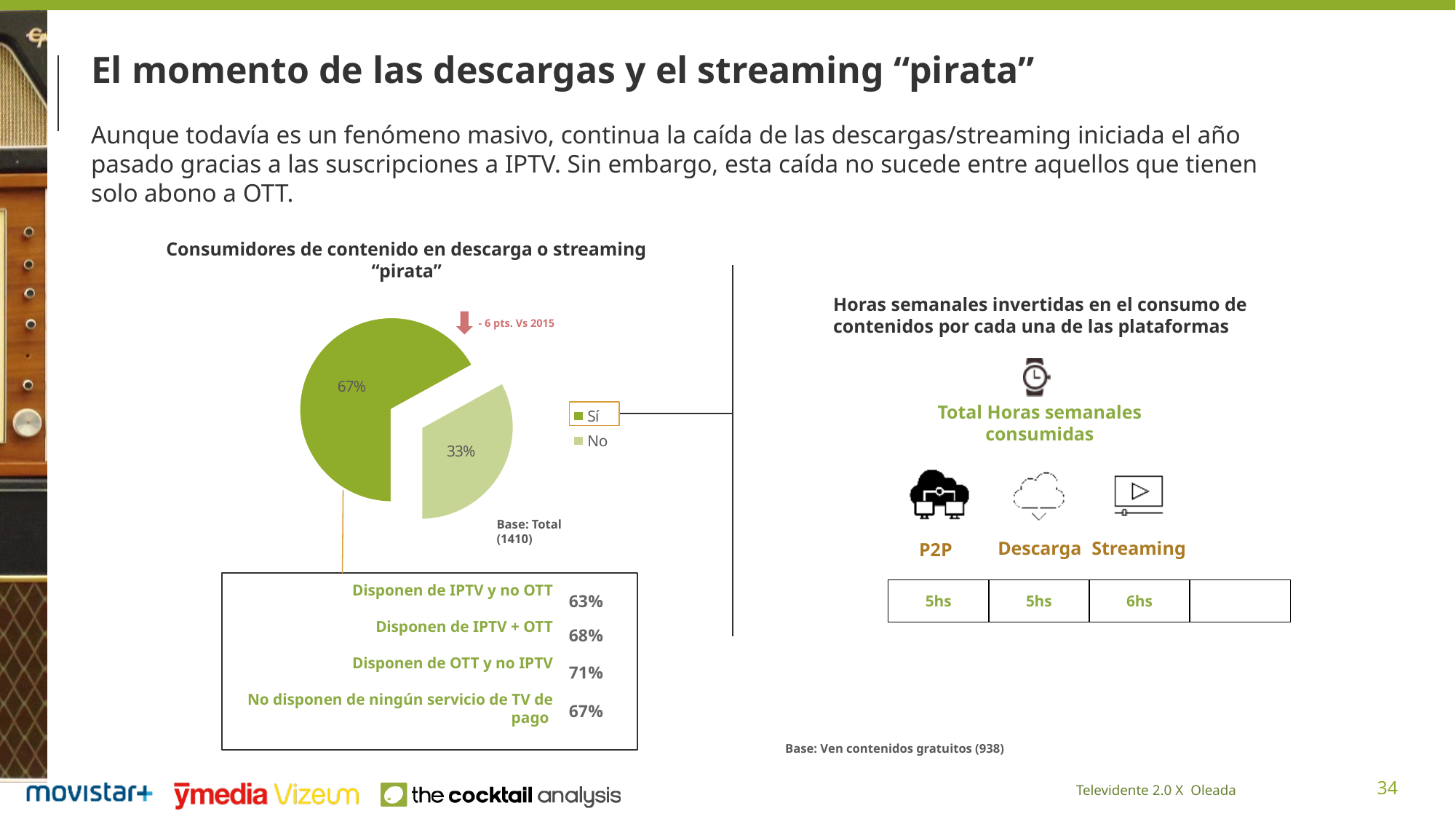
According to the annotation on the pie chart, how has the "Sí" share changed versus 2015? - 6 pts. In the breakdown box below the pie chart, what percentage is shown for "Disponen de OTT y no IPTV"? 71% Which slice of the pie chart is the smallest? No What type of chart is "Consumidores de contenido en descarga o streaming “pirata”"? pie chart What is the difference in percentage points between the "Sí" and "No" slices of the pie chart? 34 How many entries does the pie chart's legend list? 2 Which slice of the pie chart is the largest? Sí In the pie chart, what share of respondents answered "No"? 33% What is the base (sample size) stated for the pie chart? Total (1410) Is the "Sí" slice of the pie chart larger or smaller than the "No" slice? larger In the pie chart, what share of respondents answered "Sí"? 67% How many slices does the pie chart have? 2